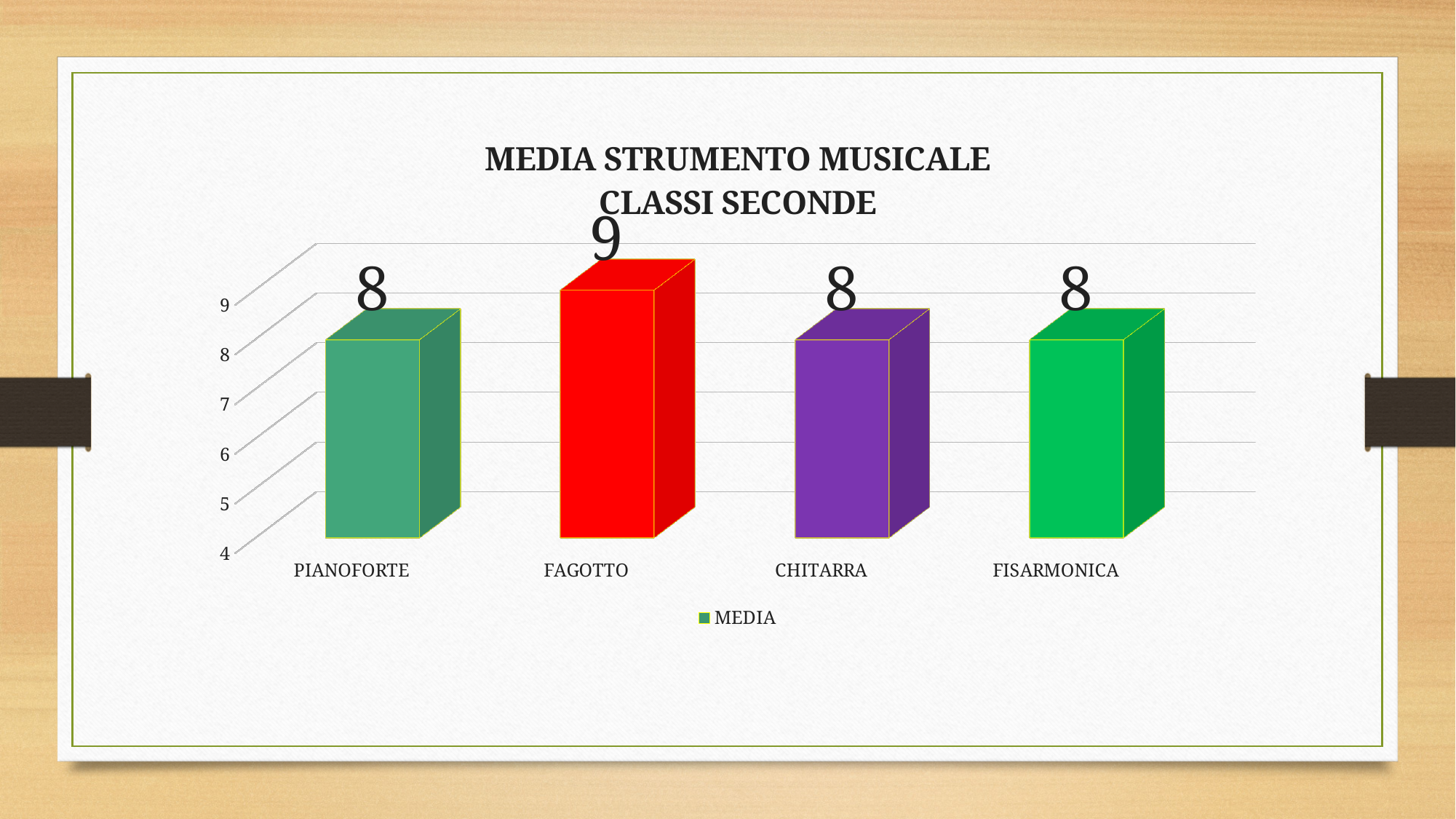
How many series does the legend list? 1 How many instruments are shown on the chart? 4 What is the value for FAGOTTO? 9 What kind of chart is shown on the slide? bar chart What is the title of the chart? MEDIA STRUMENTO MUSICALE CLASSI SECONDE Which is larger, the value for FAGOTTO or the value for PIANOFORTE? FAGOTTO What is the difference between the values for FAGOTTO and CHITARRA? 1 Which instrument has the highest value? FAGOTTO What is the value for CHITARRA? 8 What is the value for PIANOFORTE? 8 Is the value for FAGOTTO greater or less than 7? greater What is the value for FISARMONICA? 8